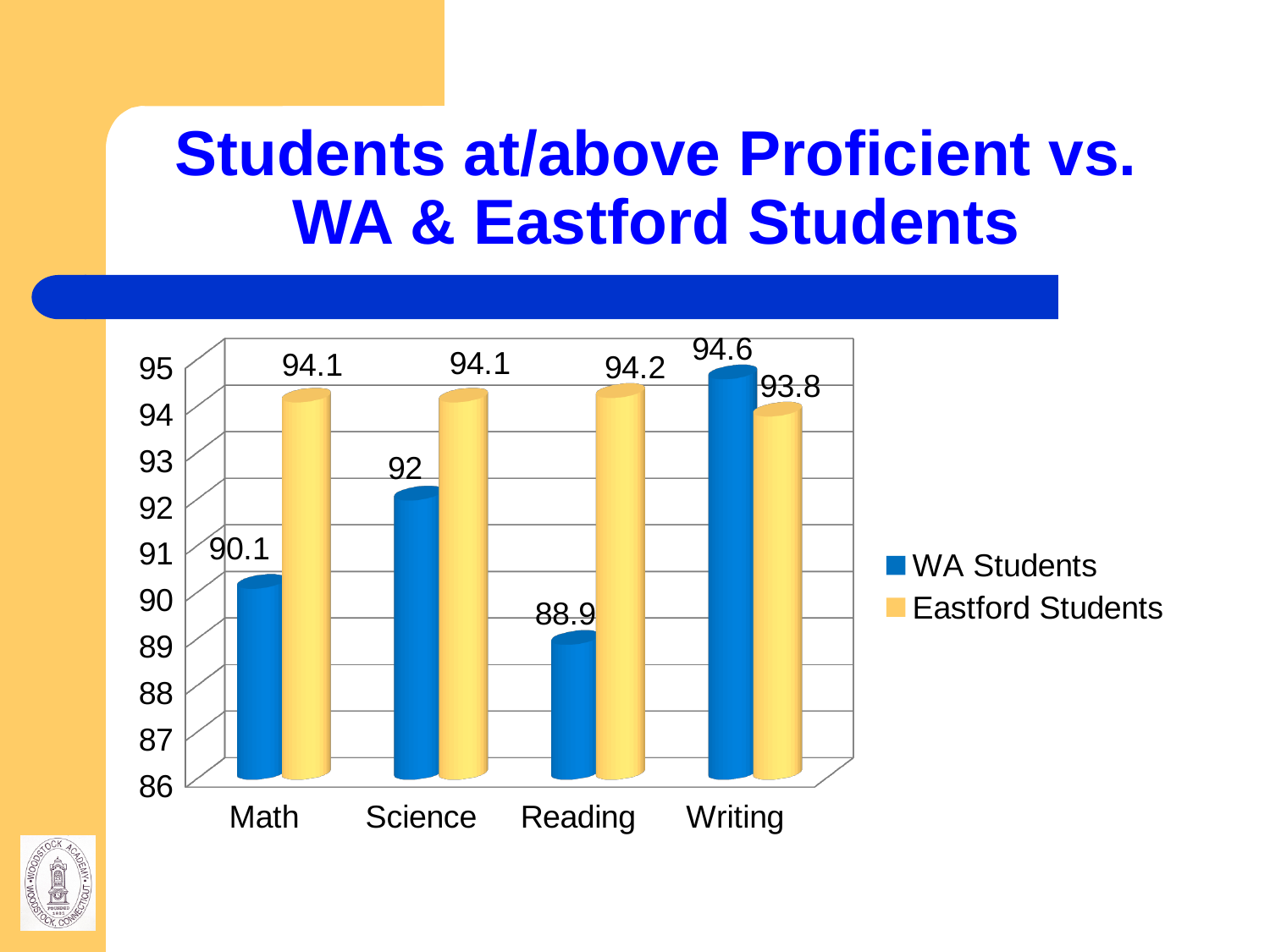
What is the difference between the Eastford Students and WA Students values in Reading? 5.3 Which is larger in Writing, the WA Students value or the Eastford Students value? WA Students In which subject is the WA Students value highest? Writing Which colour represents Eastford Students in the chart? Yellow In which subject is the WA Students value lowest? Reading What is the value for Eastford Students in Writing? 93.8 What is the value for WA Students in Writing? 94.6 What kind of chart is shown on the slide? Bar chart How many subjects are shown on the x axis? 4 How many series does the legend list? 2 What is the value for WA Students in Math? 90.1 What is the value for Eastford Students in Reading? 94.2